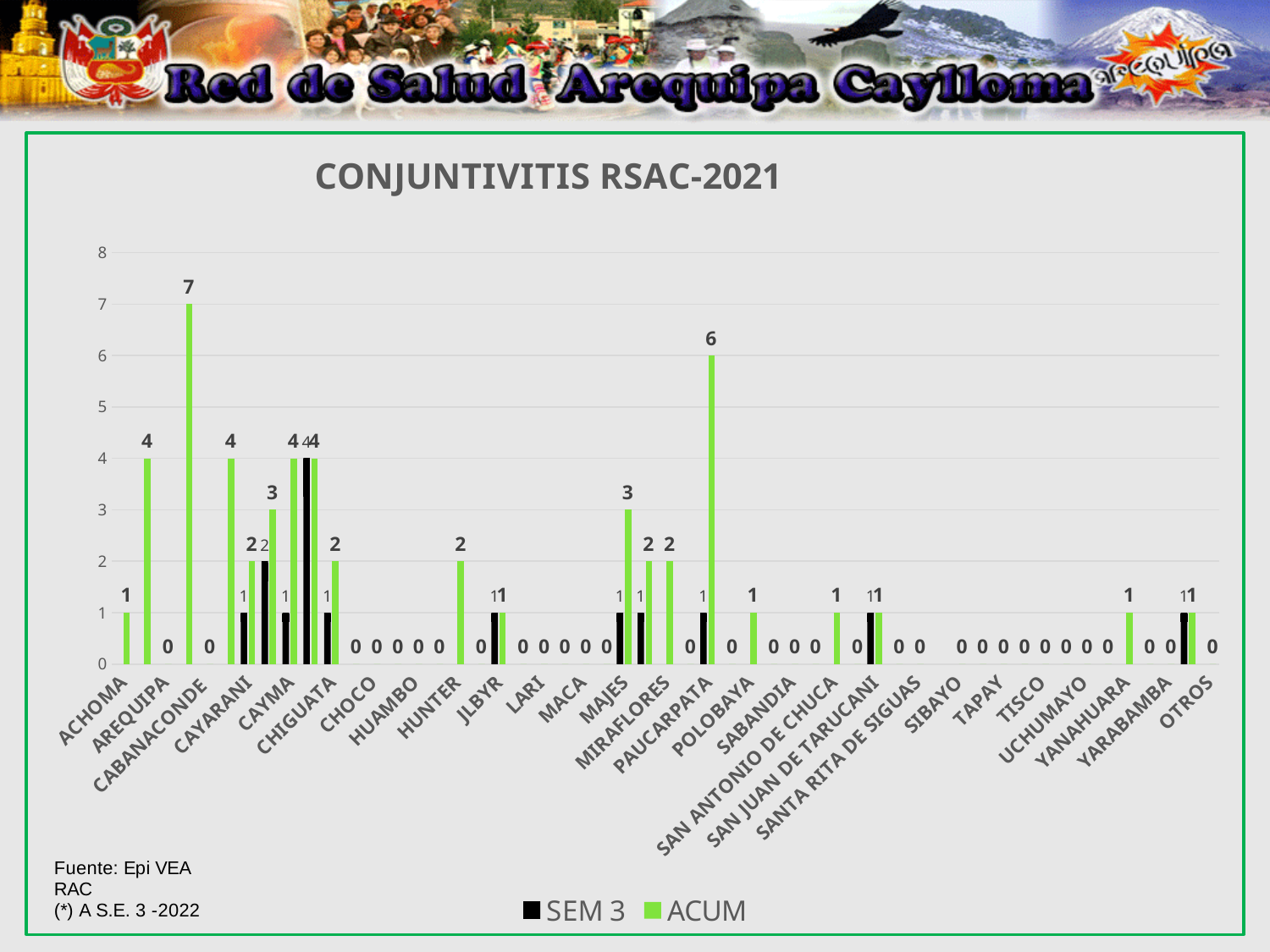
What is the ACUM value for CABANACONDE? 0 What is the ACUM value for AREQUIPA? 0 What kind of chart is shown on the slide? bar chart What is the difference between the ACUM values for CABANACONDE and PAUCARPATA? 6 Is the ACUM value for CABANACONDE greater or less than 5? less What is the highest value labelled on any bar in the chart? 7 How many series does the legend list? 2 Which has the larger ACUM value, CABANACONDE or PAUCARPATA? PAUCARPATA What is the ACUM value for PAUCARPATA? 6 What is the ACUM value for HUNTER? 2 Which series is shown in green in the legend? ACUM What is the title of the chart? CONJUNTIVITIS RSAC-2021